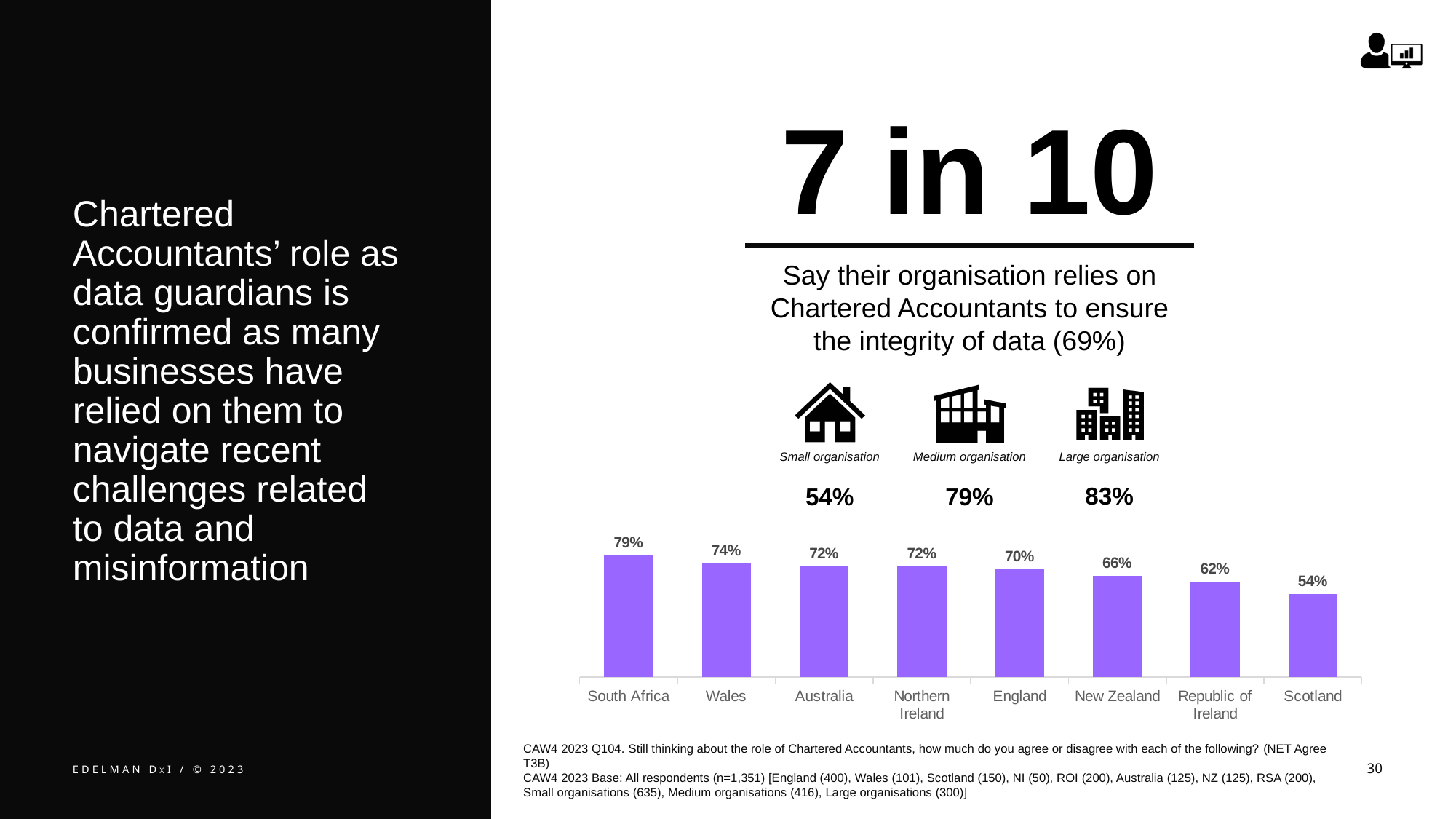
What is the difference between the values for South Africa and Scotland in the bar chart? 25% What is the value for Republic of Ireland in the bar chart? 62% What colour are the bars in the bar chart? Purple What kind of chart is shown at the bottom of the slide? Bar chart How many countries are shown in the bar chart? 8 Which country has the lowest value in the bar chart? Scotland What is the value for South Africa in the bar chart? 79% Which has a larger value in the bar chart, Wales or New Zealand? Wales Which country has the highest value in the bar chart? South Africa What is the value for England in the bar chart? 70% Do the values in the bar chart rise or fall from left to right? Fall What is the difference between the values for Australia and New Zealand in the bar chart? 6%